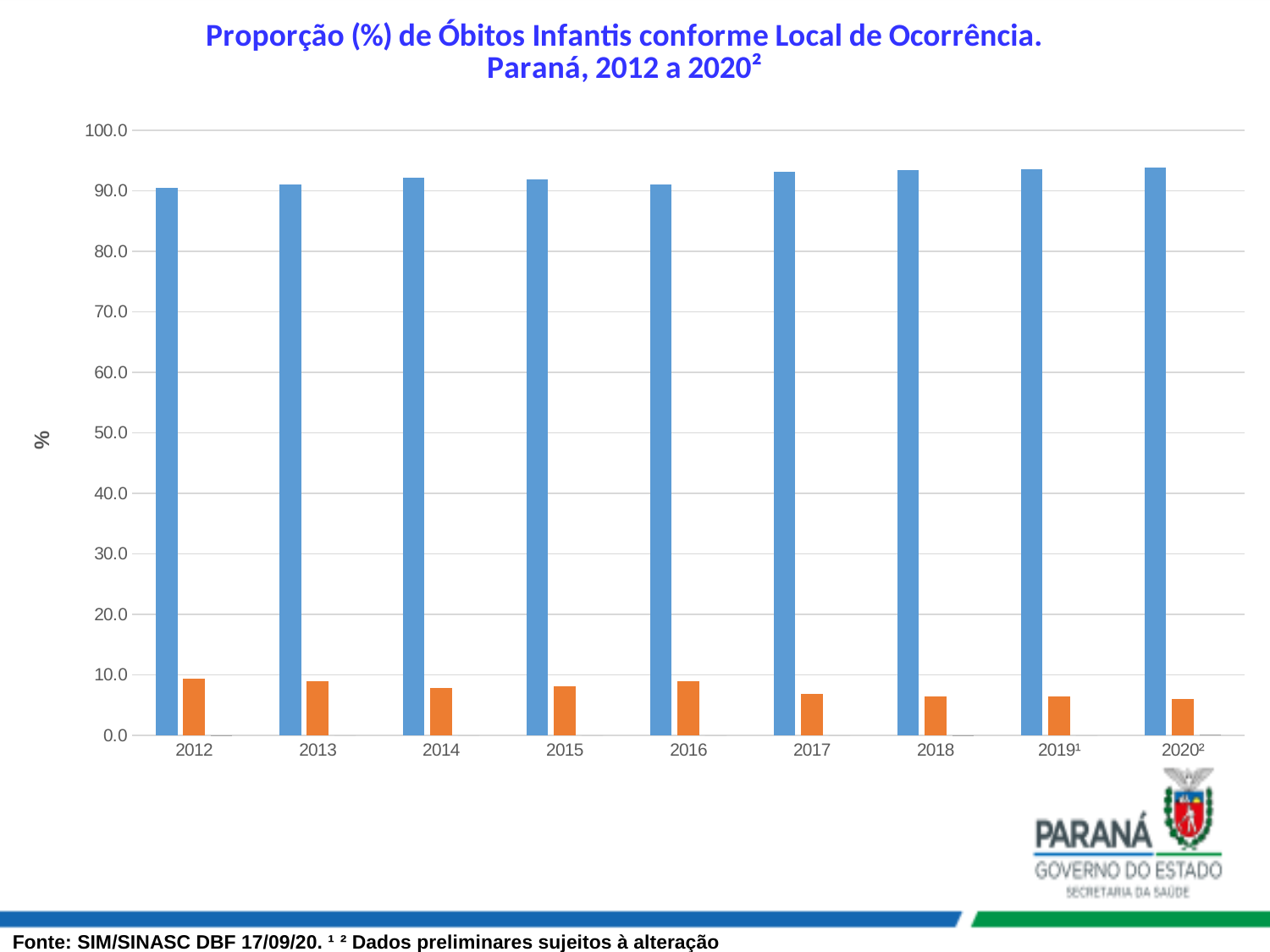
Is the value of the blue bar for 2016 greater or less than 50.0? greater Is the value of the orange bar for 2020² greater or less than 10.0? less What label is shown on the vertical axis of the chart? % What kind of chart is shown on the slide? bar chart Is the value of the blue bar for 2018 greater or less than 90.0? greater How many years are shown along the x axis of the chart? 9 What is the title of the chart? Proporção (%) de Óbitos Infantis conforme Local de Ocorrência. Paraná, 2012 a 2020² In 2015, which bar is taller, the blue bar or the orange bar? the blue bar